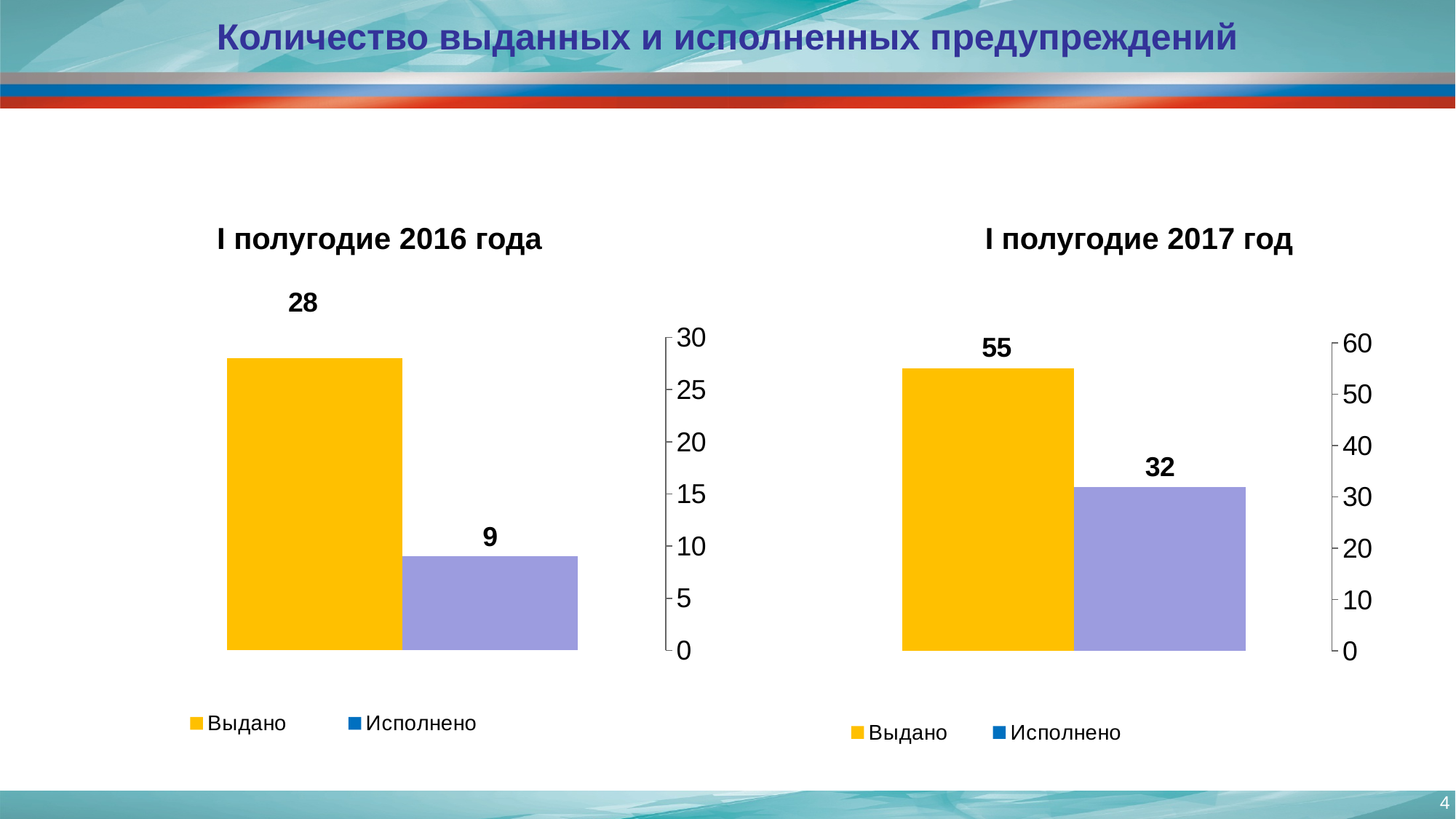
In the chart titled 'I полугодие 2016 года', what is the value for Исполнено? 9 In the chart titled 'I полугодие 2017 год', what is the difference between Выдано and Исполнено? 23 In the chart titled 'I полугодие 2017 год', what is the value for Исполнено? 32 In the chart titled 'I полугодие 2017 год', what is the value for Выдано? 55 What kind of chart is the chart titled 'I полугодие 2017 год'? bar chart In the chart titled 'I полугодие 2016 года', what is the difference between Выдано and Исполнено? 19 In the chart titled 'I полугодие 2017 год', which is larger, Выдано or Исполнено? Выдано In the chart titled 'I полугодие 2016 года', what is the value for Выдано? 28 What is the title of the chart on the left side of the slide? I полугодие 2016 года In the chart titled 'I полугодие 2017 год', is the value for Исполнено greater or less than 40? less In the chart titled 'I полугодие 2016 года', which series has the lowest value? Исполнено How many series does the legend of the chart titled 'I полугодие 2016 года' list? 2